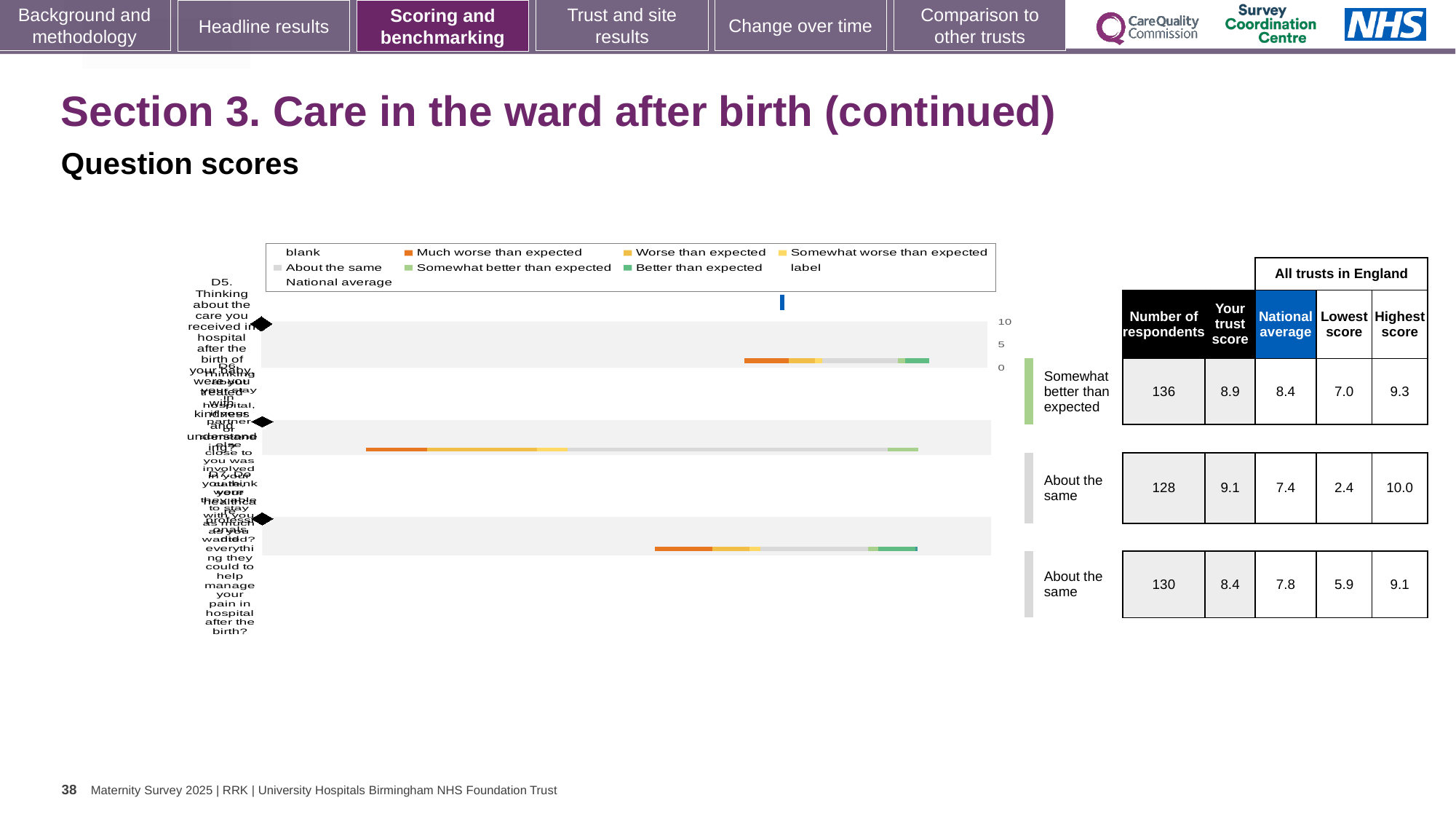
What colour represents 'Much worse than expected' in the chart legend? orange In the table beside the chart, what is the number of respondents in the first row? 136 In the table beside the chart, is 'Your trust score' or 'National average' larger in the second row? Your trust score In the table beside the chart, what is the 'National average' in the third row? 7.8 In the table beside the chart, what is 'Your trust score' in the second row? 9.1 In the table beside the chart, which row has the lowest value in the 'Lowest score' column? second row (2.4) What kind of chart is shown on the slide? bar chart In the table beside the chart, which row has the highest 'Your trust score'? second row (9.1) In the table beside the chart, what is the difference between 'Your trust score' and 'National average' in the first row? 0.5 How many stacked bars are plotted in the chart? 3 In the table beside the chart, what is the 'Highest score' in the third row? 9.1 What is the highest tick value shown on the chart's axis? 10